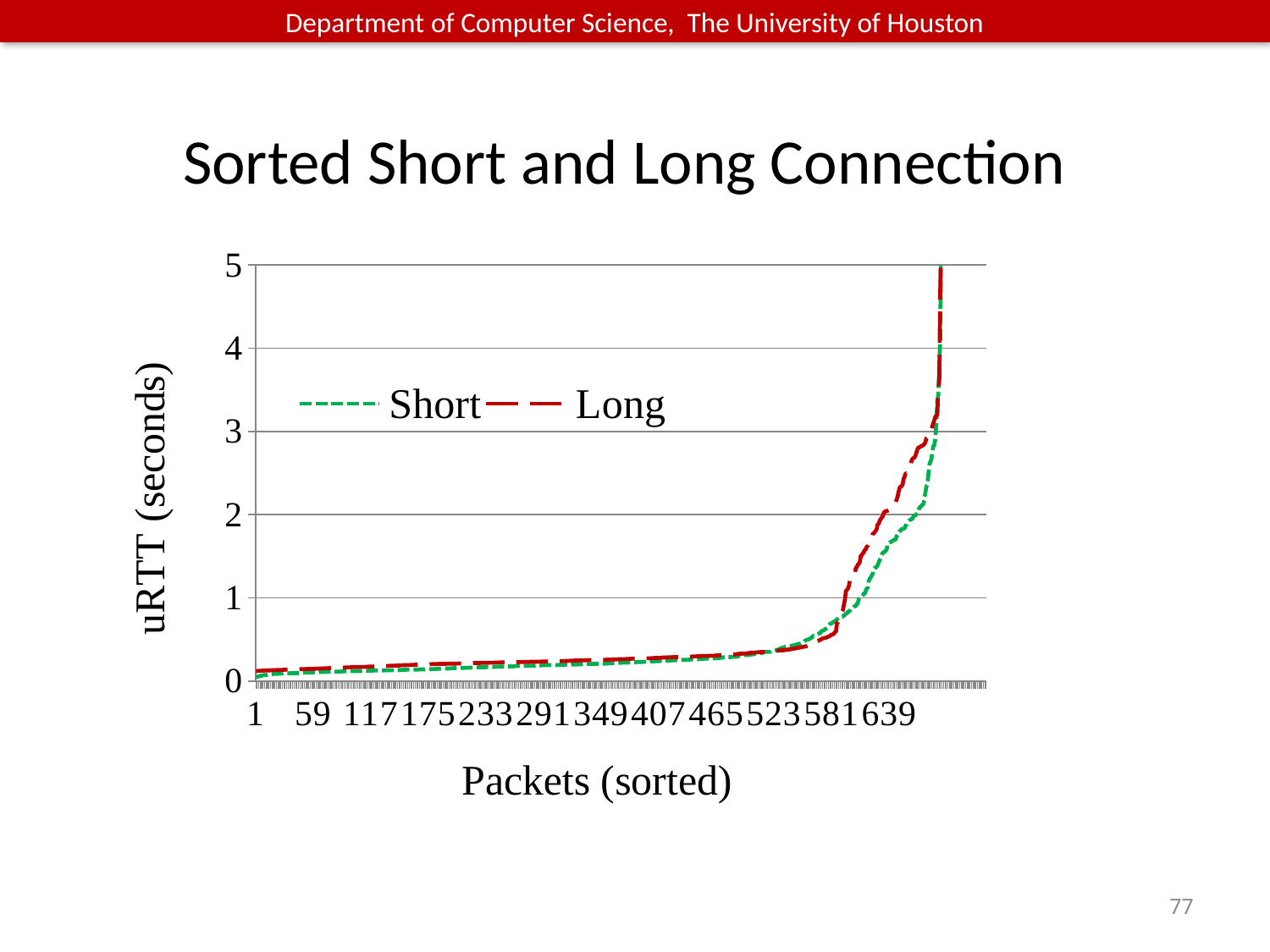
How many tick labels are shown on the x axis? 12 Is the uRTT value for the Long series at packet 639 greater or less than 3? less How many series does the legend list? 2 What is the title of the chart? Sorted Short and Long Connection Do the uRTT values for the Long series rise or fall along the x axis? rise Is the uRTT value for the Short series at packet 1 greater or less than 1? less What are the names of the two series in the legend? Short and Long Is the uRTT value for the Short series at packet 349 greater or less than 1? less Do the uRTT values for the Short series rise or fall as the packet index increases along the x axis? rise What kind of chart is shown on the slide? line chart